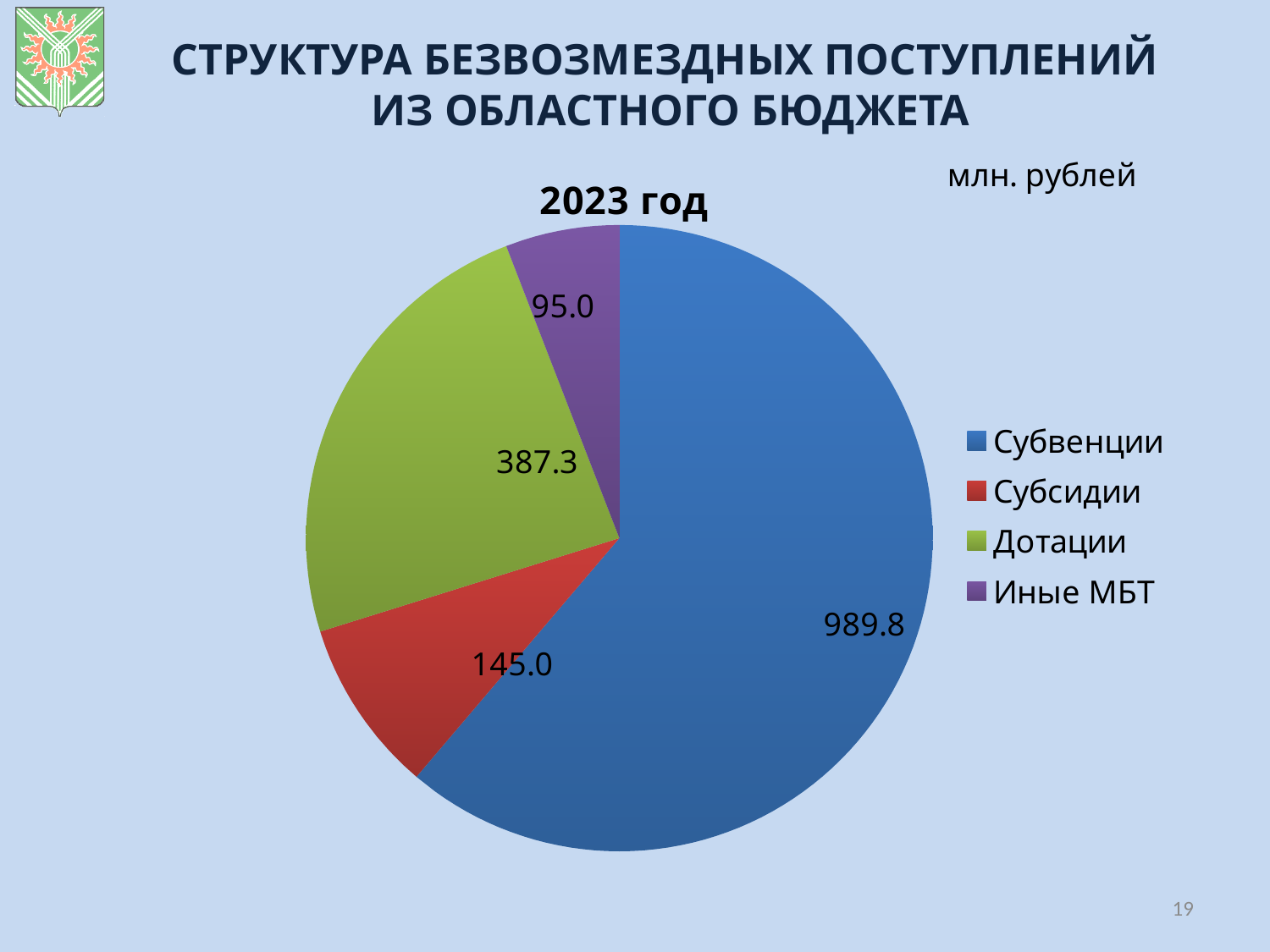
What is the total of all slices in the pie chart? 1617.1 What is the value for Субвенции in the 2023 год pie chart? 989.8 What unit of measurement is indicated for the chart values? млн. рублей What is the difference between the values for Субвенции and Дотации? 602.5 What is the value for Дотации in the 2023 год pie chart? 387.3 Which is larger, the value for Субсидии or the value for Дотации? Дотации What is the value for Иные МБТ in the 2023 год pie chart? 95.0 What type of chart is shown on the slide? Pie chart What is the value for Субсидии in the 2023 год pie chart? 145.0 Which category has the smallest slice in the pie chart? Иные МБТ Which category has the largest slice in the pie chart? Субвенции How many categories does the pie chart show? 4